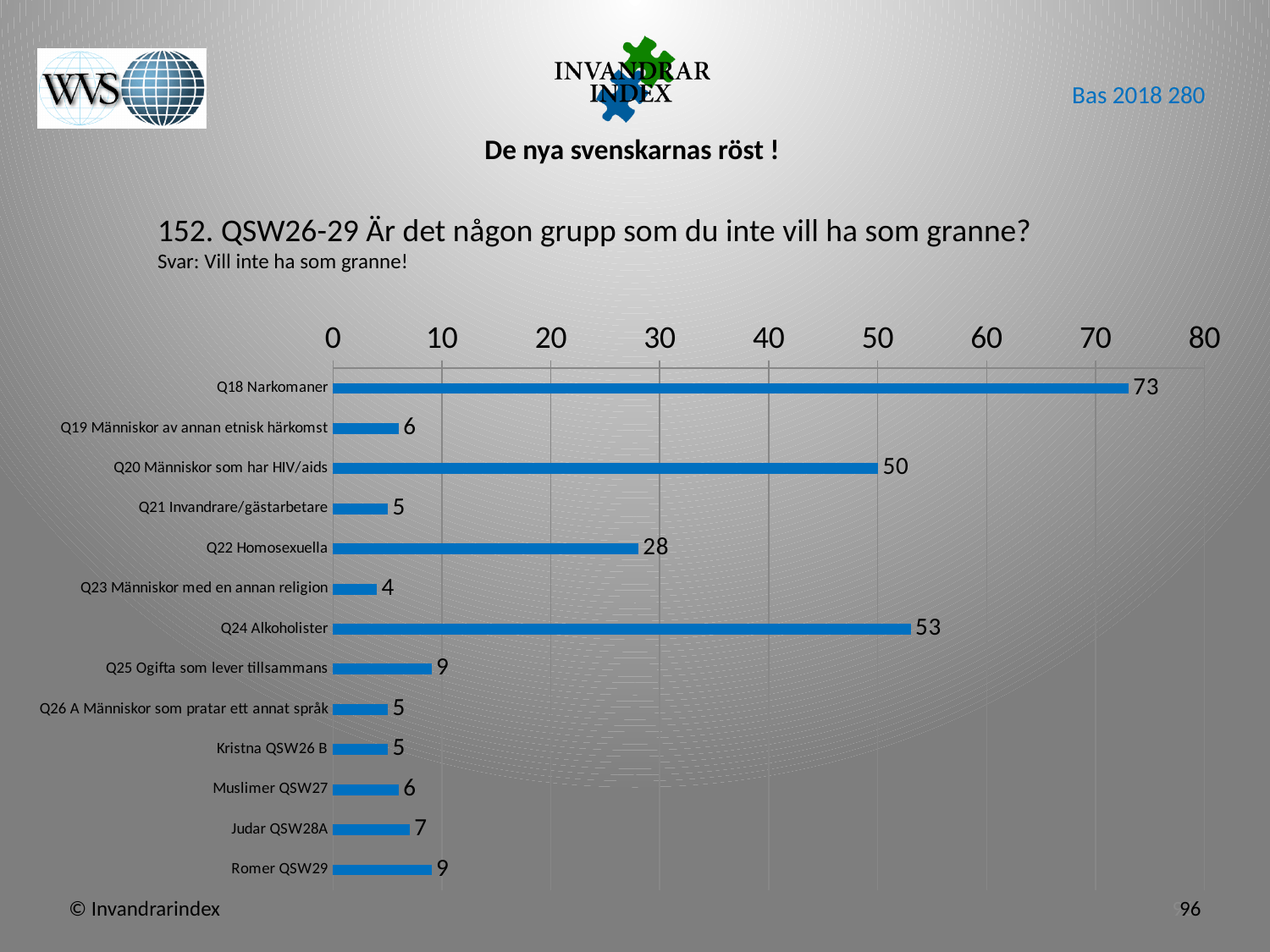
What is the value for Q24 Alkoholister? 53 Which category has the lowest value? Q23 Människor med en annan religion Which is larger, the value for Q24 Alkoholister or the value for Q20 Människor som har HIV/aids? Q24 Alkoholister Which category has the highest value? Q18 Narkomaner What is the value for Q22 Homosexuella? 28 Is the value for Q22 Homosexuella greater or less than 30? less What is the difference between the values for Q20 Människor som har HIV/aids and Q22 Homosexuella? 22 What is the value for Q18 Narkomaner? 73 What is the difference between the values for Q18 Narkomaner and Q24 Alkoholister? 20 How many categories are shown in the chart? 13 What kind of chart is shown on the slide? bar chart What is the value for Judar QSW28A? 7